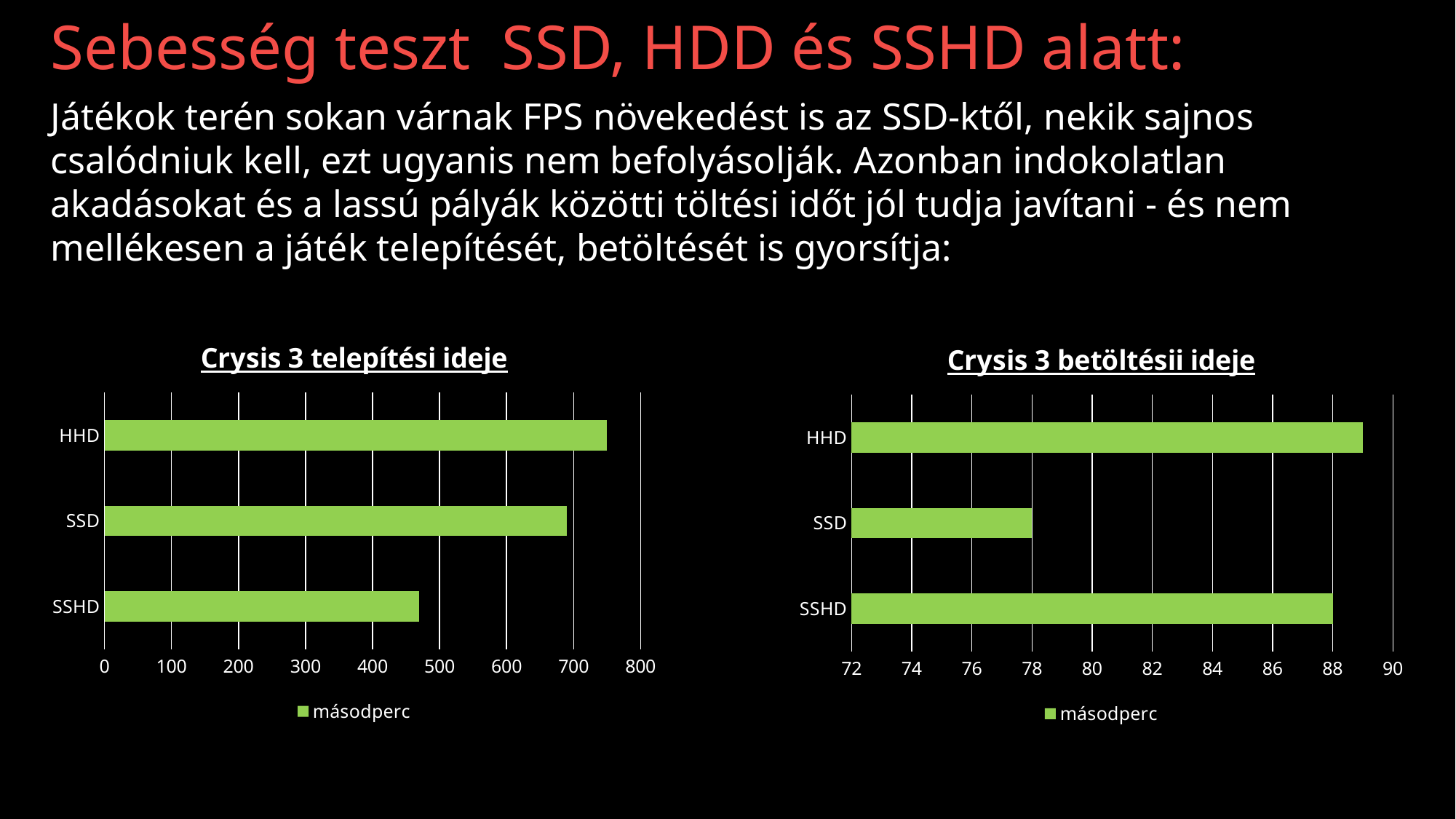
In the chart titled "Crysis 3 betöltésii ideje", what is the value for SSD? 78 In the chart titled "Crysis 3 telepítési ideje", is the value for SSHD greater or less than 500? less In the chart titled "Crysis 3 telepítési ideje", is the value for HHD greater or less than 700? greater In the chart titled "Crysis 3 telepítési ideje", which is larger, the value for HHD or the value for SSD? HHD In the chart titled "Crysis 3 betöltésii ideje", which category has the highest value? HHD In the chart titled "Crysis 3 betöltésii ideje", which category has the lowest value? SSD In the chart titled "Crysis 3 betöltésii ideje", what series name does the legend show? másodperc In the chart titled "Crysis 3 telepítési ideje", which category has the lowest value? SSHD In the chart titled "Crysis 3 telepítési ideje", which category has the highest value? HHD In the chart titled "Crysis 3 betöltésii ideje", is the value for HHD greater or less than 88? greater In the chart titled "Crysis 3 telepítési ideje", what kind of chart is shown? bar chart In the chart titled "Crysis 3 telepítési ideje", how many categories are plotted? 3